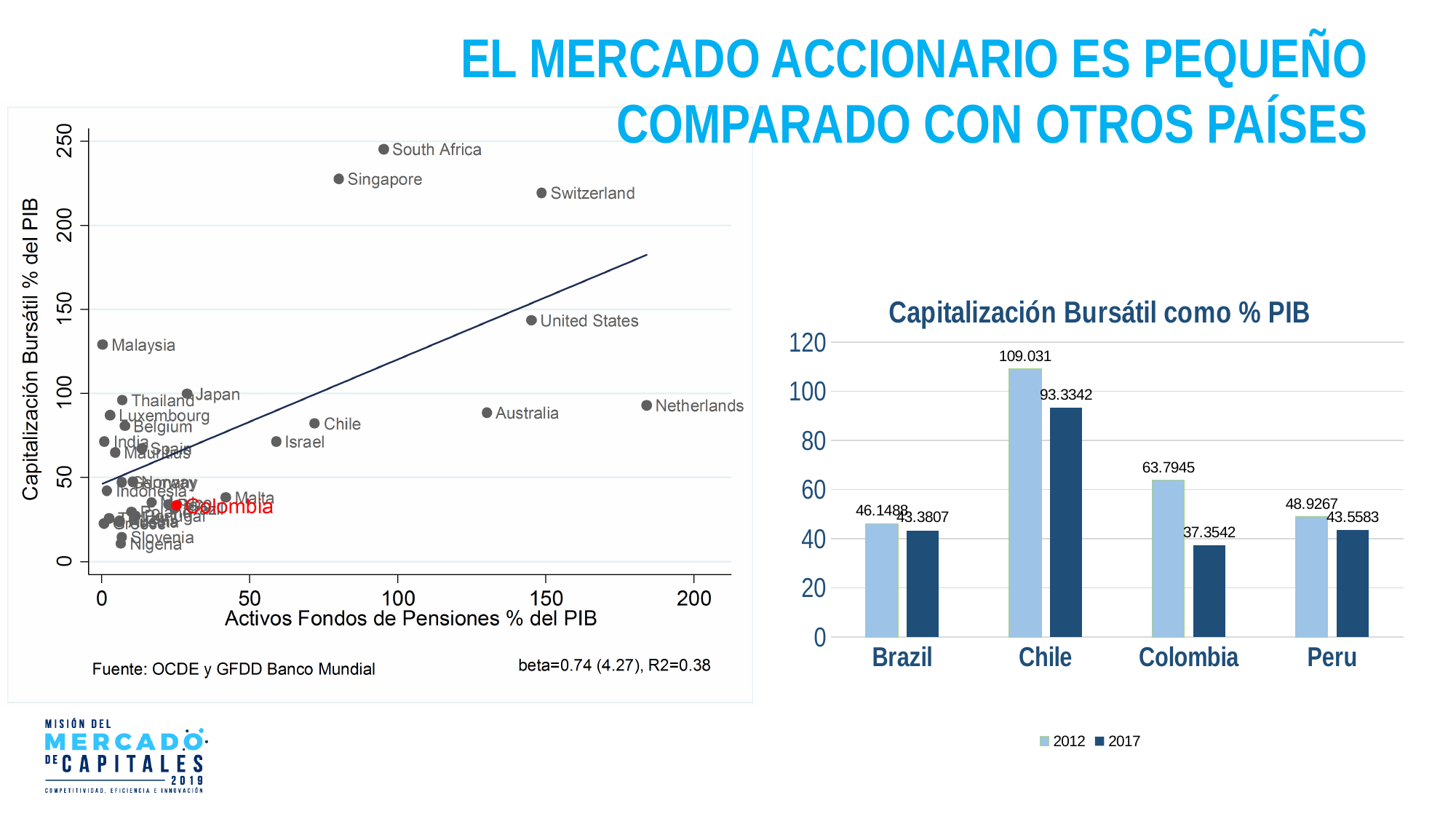
In the 'Capitalización Bursátil como % PIB' chart, what is the value for Peru in 2012? 48.9267 In the scatter plot on the left, is the value of Capitalización Bursátil % del PIB for South Africa greater or less than 200? greater In the scatter plot on the left, is the value of Activos Fondos de Pensiones % del PIB for Netherlands greater or less than 150? greater In the 'Capitalización Bursátil como % PIB' chart, what is the value for Colombia in 2017? 37.3542 In the 'Capitalización Bursátil como % PIB' chart, which country has the highest value in 2017? Chile In the 'Capitalización Bursátil como % PIB' chart, what is the value for Chile in 2012? 109.031 How many countries are shown on the x axis of the 'Capitalización Bursátil como % PIB' chart? 4 In the 'Capitalización Bursátil como % PIB' chart, which is larger: Brazil's 2012 value or Peru's 2012 value? Peru's 2012 value In the 'Capitalización Bursátil como % PIB' chart, which country has the lowest value in 2017? Colombia What kind of chart is the chart on the left side of the slide? Scatter plot In the 'Capitalización Bursátil como % PIB' chart, what is the difference between Colombia's 2012 and 2017 values? 26.4403 How many series does the legend of the 'Capitalización Bursátil como % PIB' chart list? 2